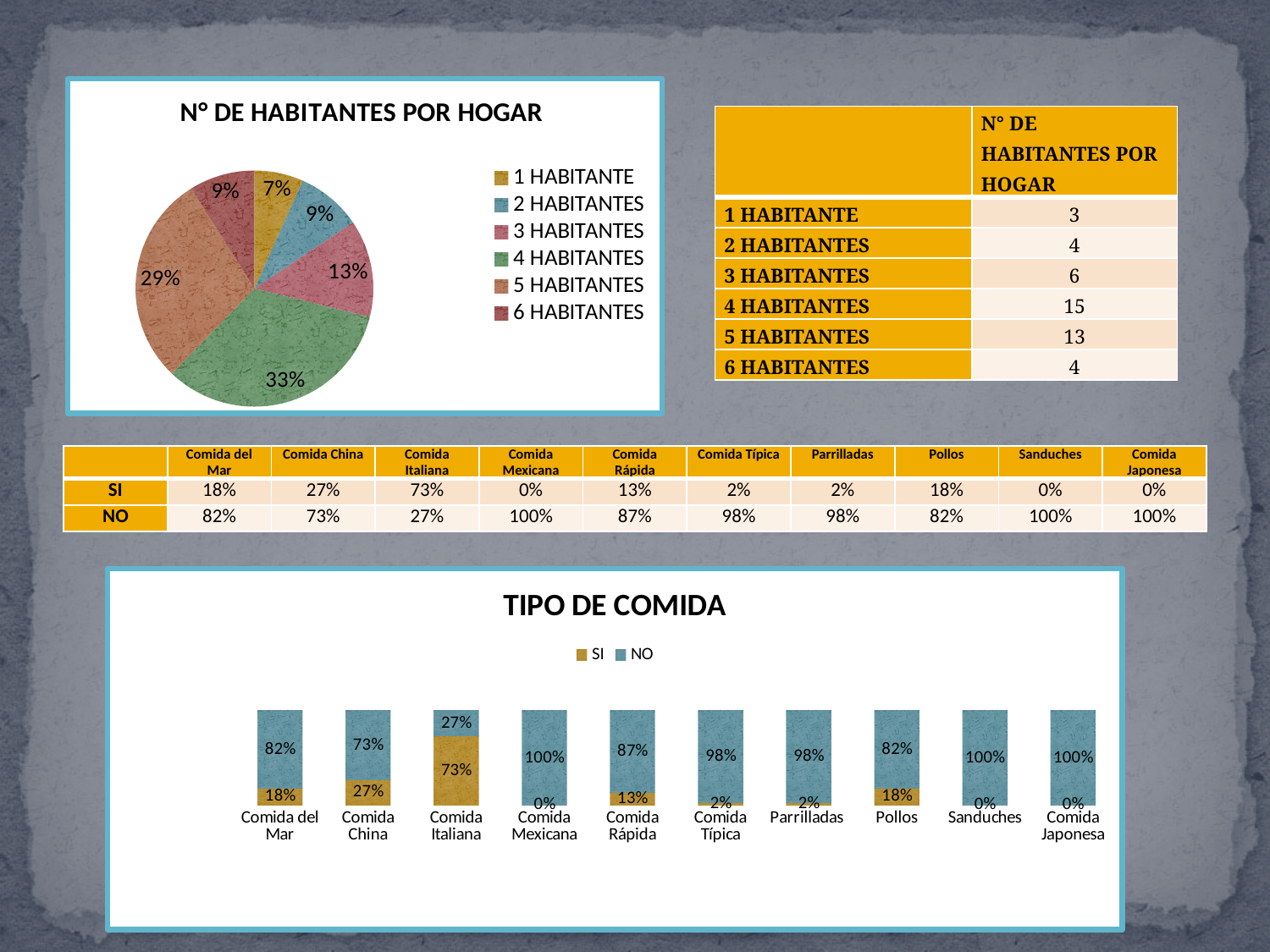
In the pie chart "N° DE HABITANTES POR HOGAR", which category has the smallest slice? 1 HABITANTE In the "TIPO DE COMIDA" chart, what is the SI value for Comida Italiana? 73% In the pie chart "N° DE HABITANTES POR HOGAR", which category has the largest slice? 4 HABITANTES In the pie chart "N° DE HABITANTES POR HOGAR", what is the difference between the 4 HABITANTES slice and the 5 HABITANTES slice? 4% In the "TIPO DE COMIDA" chart, how many series does the legend list? 2 In the "TIPO DE COMIDA" chart, what is the NO value for Comida China? 73% What kind of chart is "TIPO DE COMIDA"? Stacked bar chart In the "TIPO DE COMIDA" chart, is the SI value for Comida del Mar or for Comida Rápida larger? Comida del Mar In the pie chart "N° DE HABITANTES POR HOGAR", what share of the pie is 1 HABITANTE? 7% In the pie chart "N° DE HABITANTES POR HOGAR", how many categories does the legend list? 6 In the pie chart "N° DE HABITANTES POR HOGAR", what share of the pie is 4 HABITANTES? 33% In the "TIPO DE COMIDA" chart, which category has the highest SI value? Comida Italiana